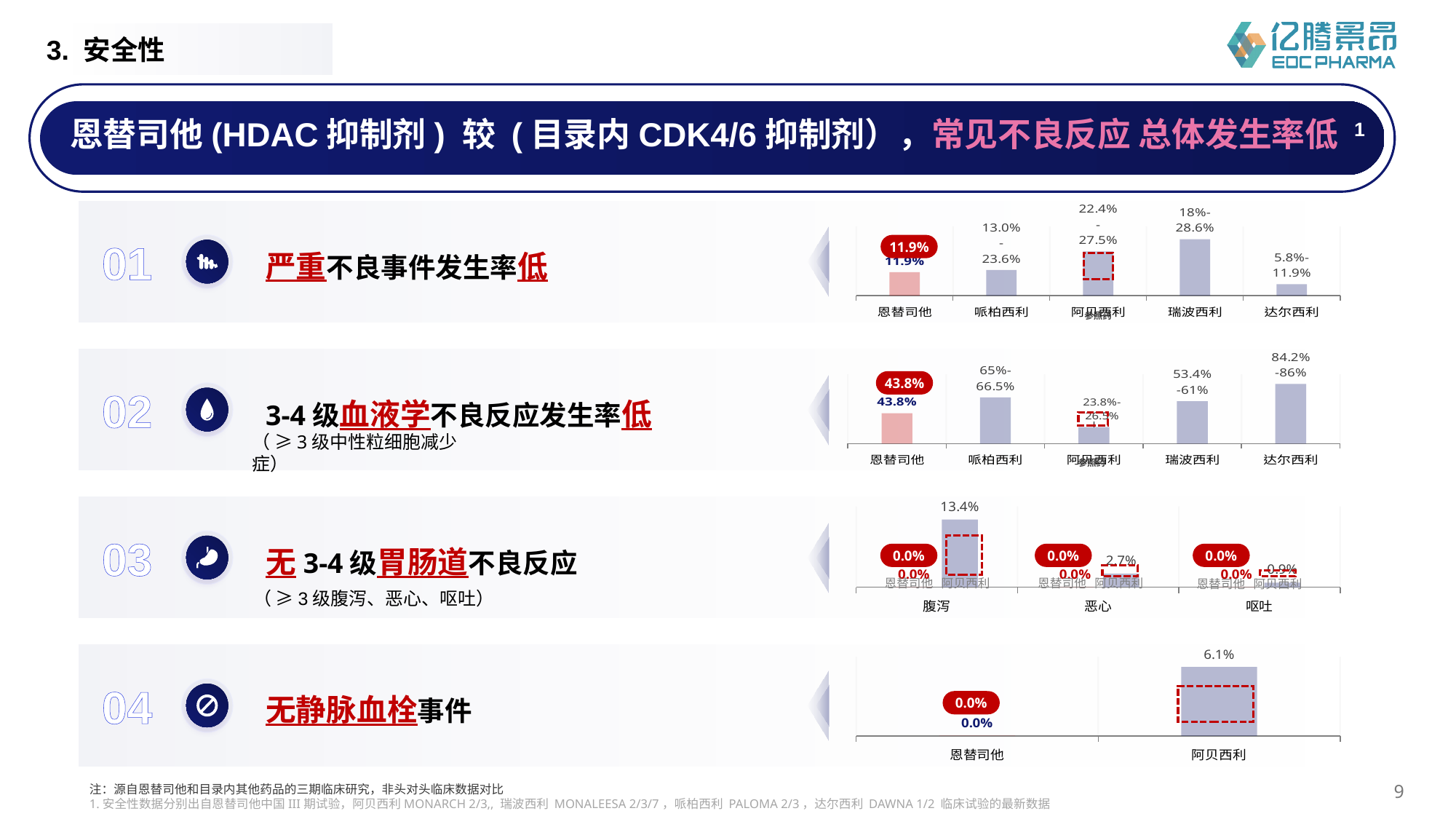
In the chart for row 03 (无3-4级胃肠道不良反应), what is the difference between 阿贝西利 and 恩替司他 under 腹泻? 13.4% In the chart for row 02 (3-4级血液学不良反应发生率低), what range is shown for 哌柏西利? 65%-66.5% In the chart for row 01 (严重不良事件发生率低), what range is shown for 瑞波西利? 18%-28.6% In the chart for row 04 (无静脉血栓事件), what is the value for 阿贝西利? 6.1% In the chart for row 01 (严重不良事件发生率低), what is the value for 恩替司他? 11.9% What type of chart is used in row 04 (无静脉血栓事件)? Bar chart In the chart for row 03 (无3-4级胃肠道不良反应), what is the value for 阿贝西利 under 腹泻? 13.4% In the chart for row 01 (严重不良事件发生率低), how many drugs are compared? 5 In the chart for row 02 (3-4级血液学不良反应发生率低), which drug has the lowest bar? 阿贝西利 In the chart for row 02 (3-4级血液学不良反应发生率低), which drug has the highest bar? 达尔西利 In the chart for row 02 (3-4级血液学不良反应发生率低), what is the value for 恩替司他? 43.8% In the chart for row 03 (无3-4级胃肠道不良反应), what is the value for 阿贝西利 under 恶心? 2.7%